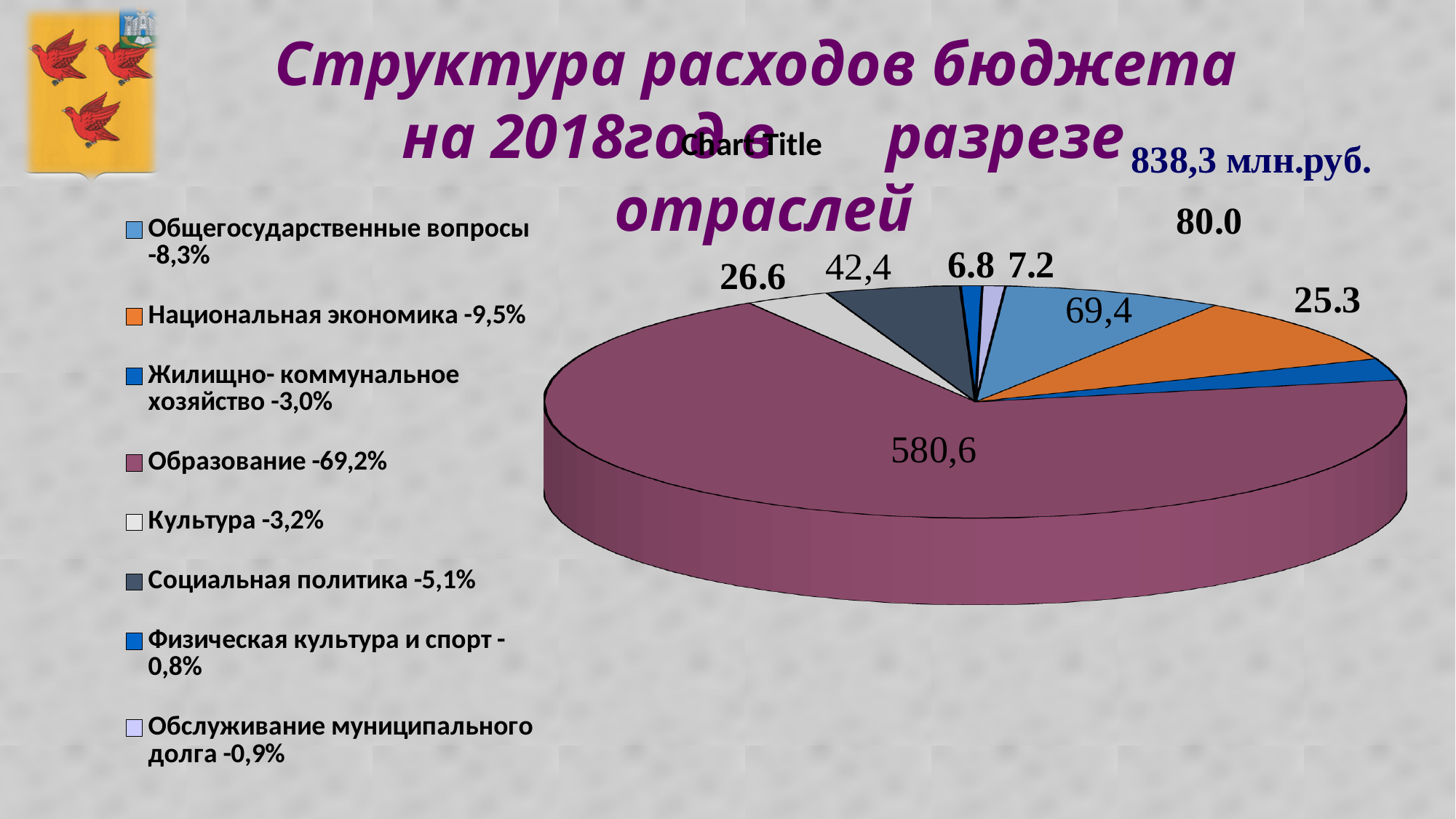
What share of the pie does Образование represent, according to the legend? 69,2% What value is labelled on the Образование slice? 580,6 What value is labelled on the Национальная экономика slice? 80.0 What value is labelled on the Социальная политика slice? 42,4 What value is labelled on the Общегосударственные вопросы slice? 69,4 What share of the pie does Национальная экономика represent, according to the legend? 9,5% Which is larger: the Культура slice or the Жилищно-коммунальное хозяйство slice? Культура Which category has the largest slice of the pie? Образование How many categories does the legend of the pie chart list? 8 What is the difference between the Национальная экономика value (80.0) and the Общегосударственные вопросы value (69,4)? 10,6 Which category has the smallest slice of the pie? Физическая культура и спорт What kind of chart is shown on the slide? pie chart